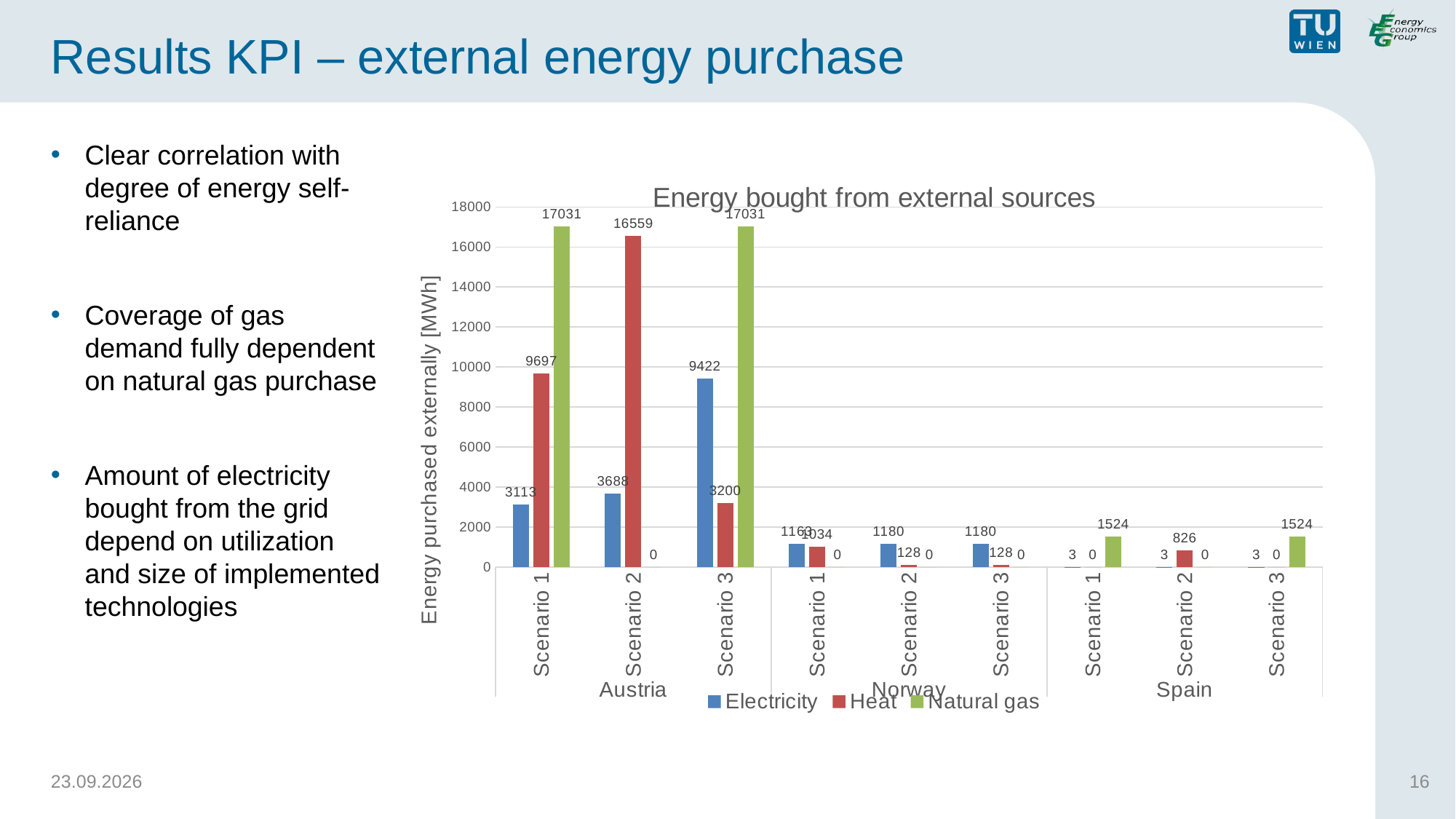
Is the Heat value for Austria Scenario 3 greater or less than 4000? less What is the Electricity value for Austria Scenario 3? 9422 What is the Heat value for Austria Scenario 2? 16559 What kind of chart is shown on the slide? bar chart Which is larger: the Heat value for Austria Scenario 1 or the Electricity value for Austria Scenario 3? Heat for Austria Scenario 1 What is the Natural gas value for Austria Scenario 1? 17031 What is the Heat value for Norway Scenario 2? 128 How many scenario categories are shown on the x axis? 9 What is the Natural gas value for Spain Scenario 1? 1524 How many series does the legend list? 3 What is the difference between the Electricity values for Austria Scenario 2 and Austria Scenario 1? 575 Which scenario has the highest Heat value? Austria Scenario 2